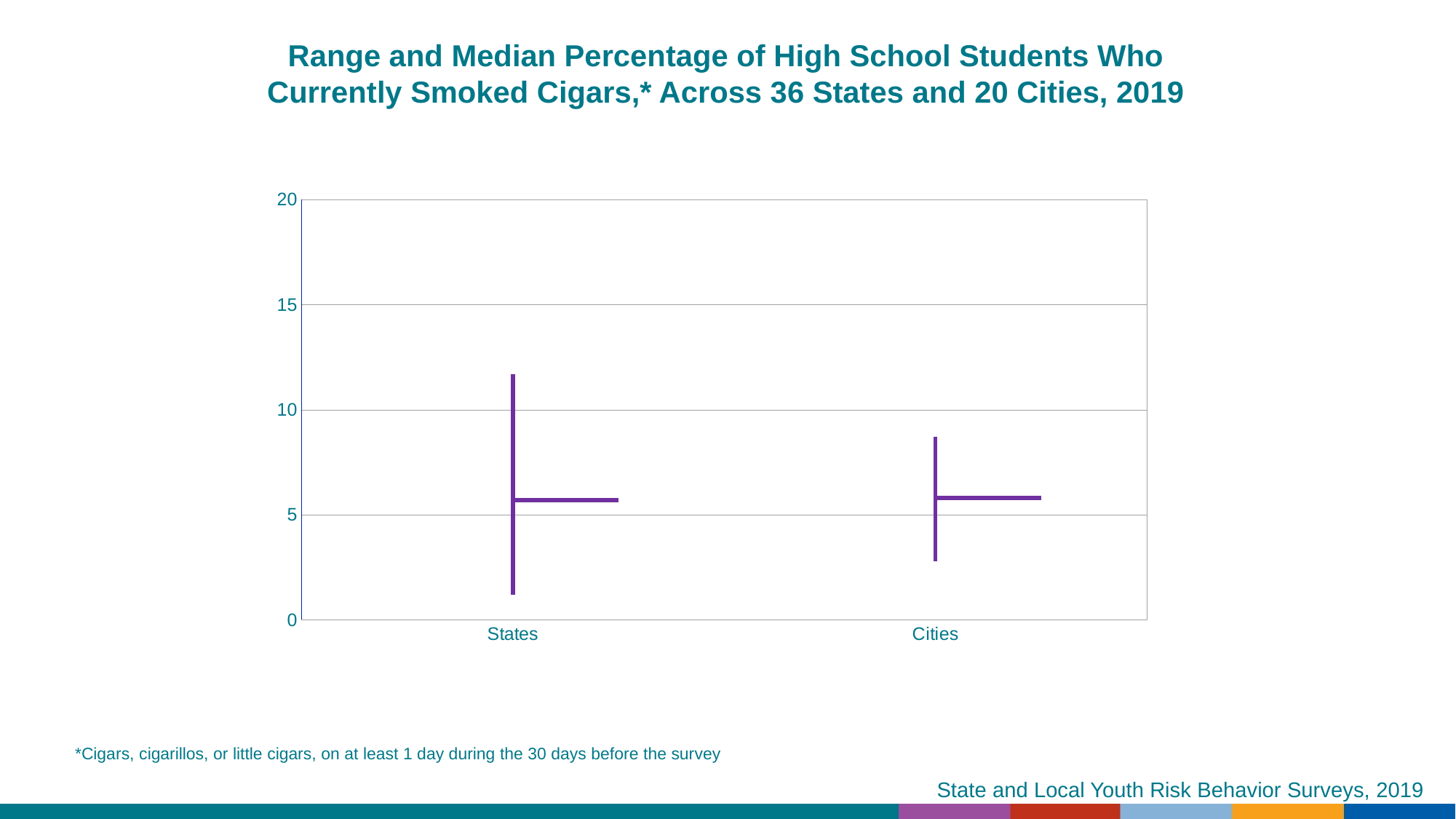
Is the maximum value for States greater or less than 10? greater What is the highest value shown on the y axis of the chart? 20 Which category has the higher maximum value, States or Cities? States Is the maximum value for Cities greater or less than 5? greater Which category has the lower minimum value, States or Cities? States Is the maximum value for Cities greater or less than 10? less How many categories are shown on the x axis of the chart? 2 What year does the chart title say the data are from? 2019